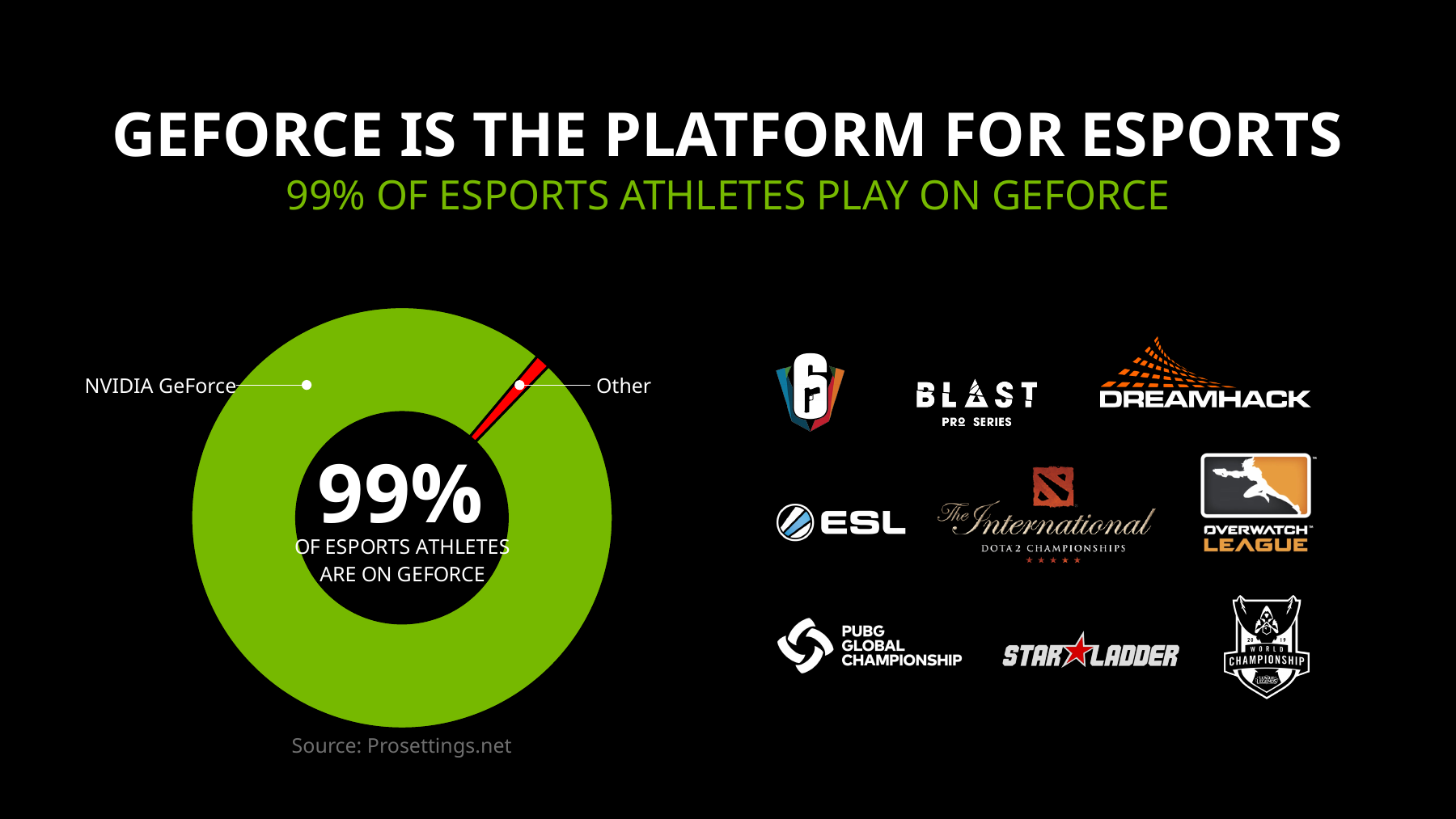
What share of esports athletes does the pie chart show for NVIDIA GeForce? 99% Which slice is larger, NVIDIA GeForce or Other? NVIDIA GeForce How many categories does the pie chart show? 2 Which category has the smallest slice in the pie chart? Other What colour is the NVIDIA GeForce slice in the pie chart? green Which category has the largest slice in the pie chart? NVIDIA GeForce What source is cited below the pie chart? Prosettings.net What kind of chart is shown on the slide? doughnut chart